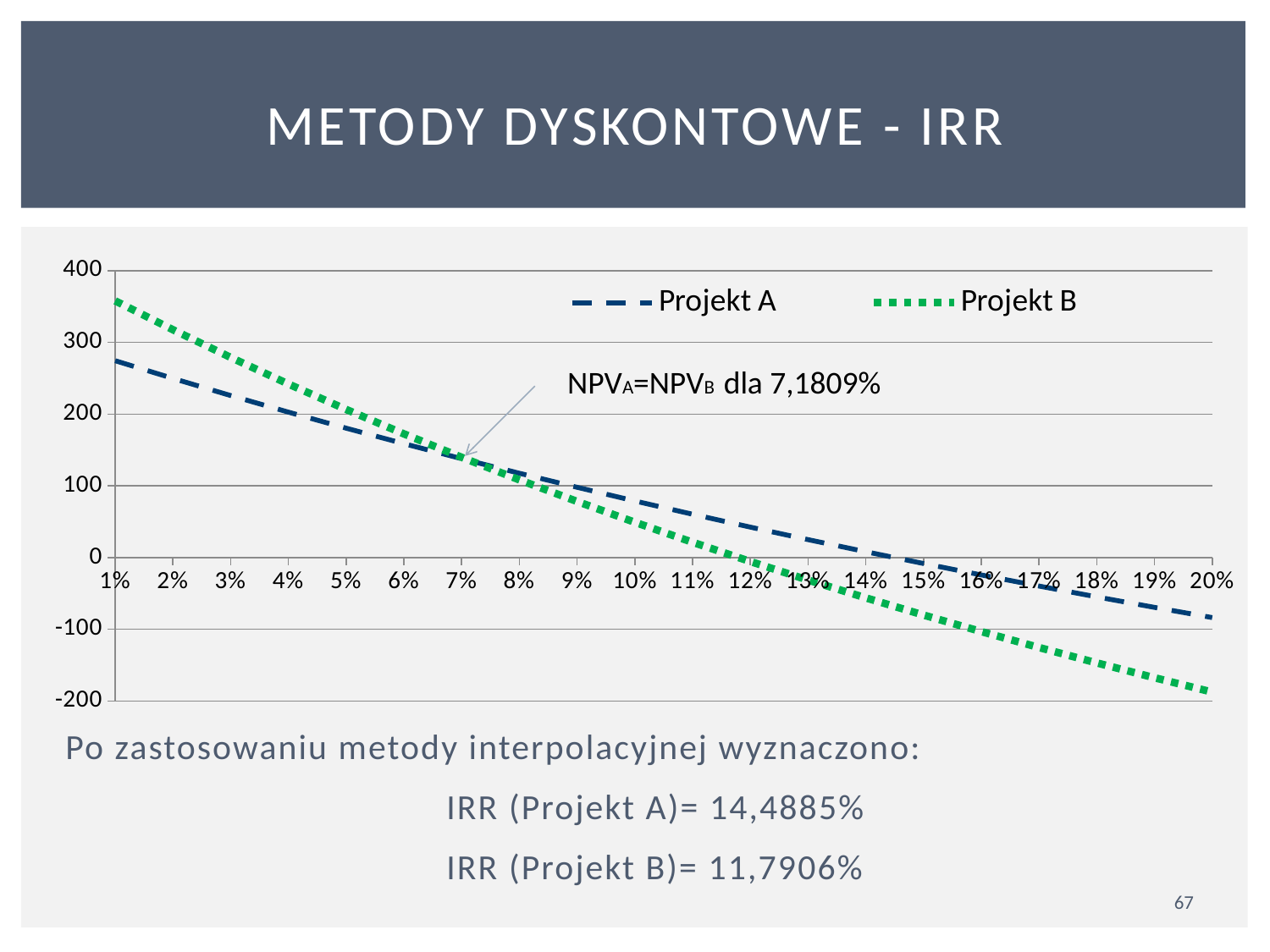
According to the annotation on the chart, at what discount rate are the NPVs of Projekt A and Projekt B equal? 7,1809% Do the values for Projekt A rise or fall as the discount rate increases along the x axis? fall How many discount-rate points are marked along the x axis? 20 At 1%, which series has the higher value, Projekt A or Projekt B? Projekt B How many series does the chart legend list? 2 What are the names of the two series in the legend? Projekt A and Projekt B What kind of chart is shown on the slide? line chart Is the value for Projekt A at 1% greater or less than 300? less Is the value for Projekt B at 20% greater or less than -100? less Do the values for Projekt B rise or fall as the discount rate increases along the x axis? fall Is the value for Projekt B at 1% greater or less than 300? greater At 20%, which series has the higher value, Projekt A or Projekt B? Projekt A